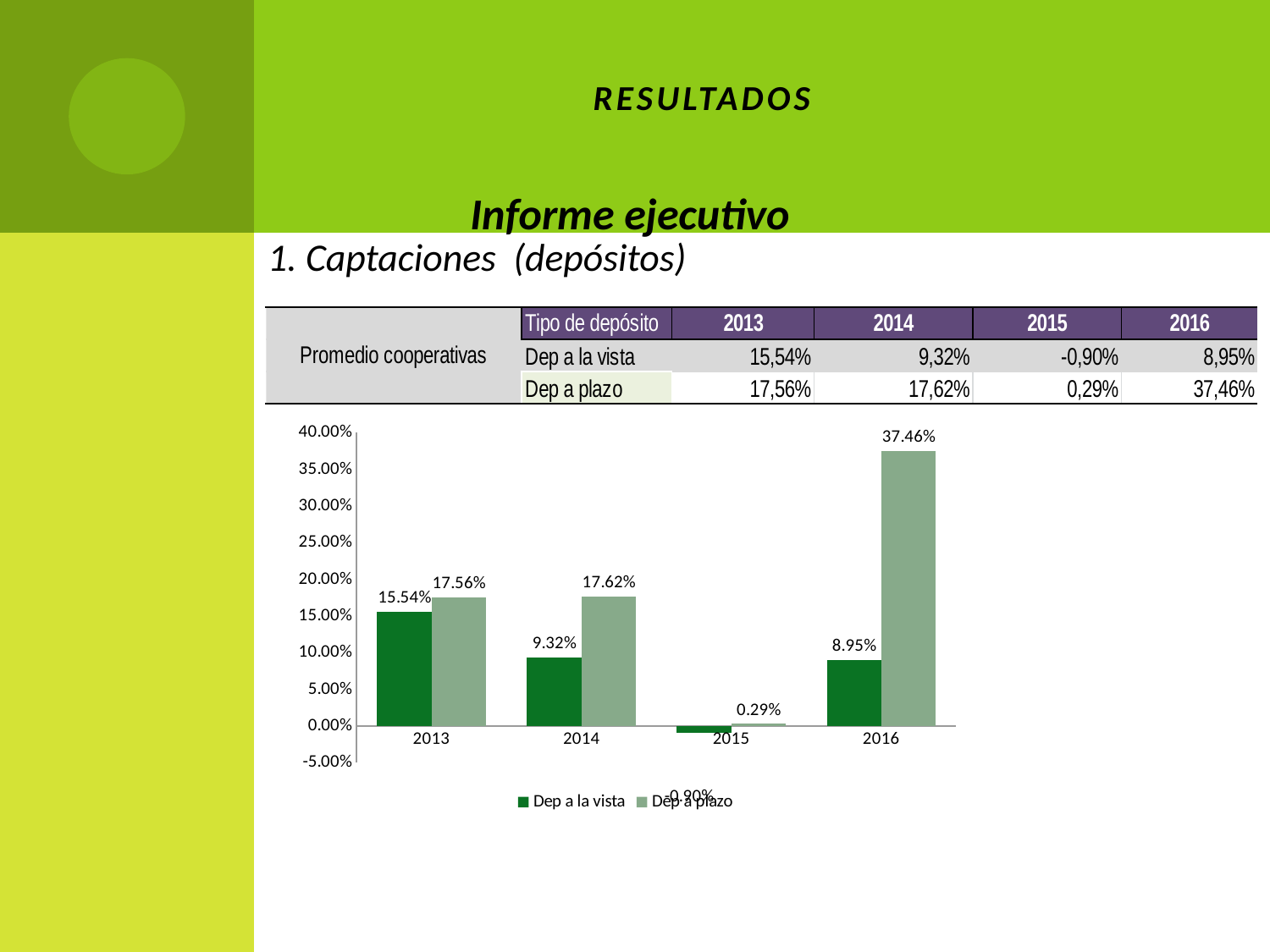
In which year is the Dep a plazo value highest? 2016 Is the value for Dep a plazo in 2016 greater or less than 35.00%? greater What is the difference between Dep a plazo and Dep a la vista in 2013? 2.02% What is the value for Dep a plazo in 2016? 37.46% In which year is the Dep a la vista value lowest? 2015 How many series does the chart legend list? 2 What is the value for Dep a la vista in 2013? 15.54% How many years are shown on the x axis of the chart? 4 What is the value for Dep a plazo in 2014? 17.62% What is the value for Dep a la vista in 2016? 8.95% Which is larger in 2014, Dep a la vista or Dep a plazo? Dep a plazo What type of chart is shown on the slide? Bar chart